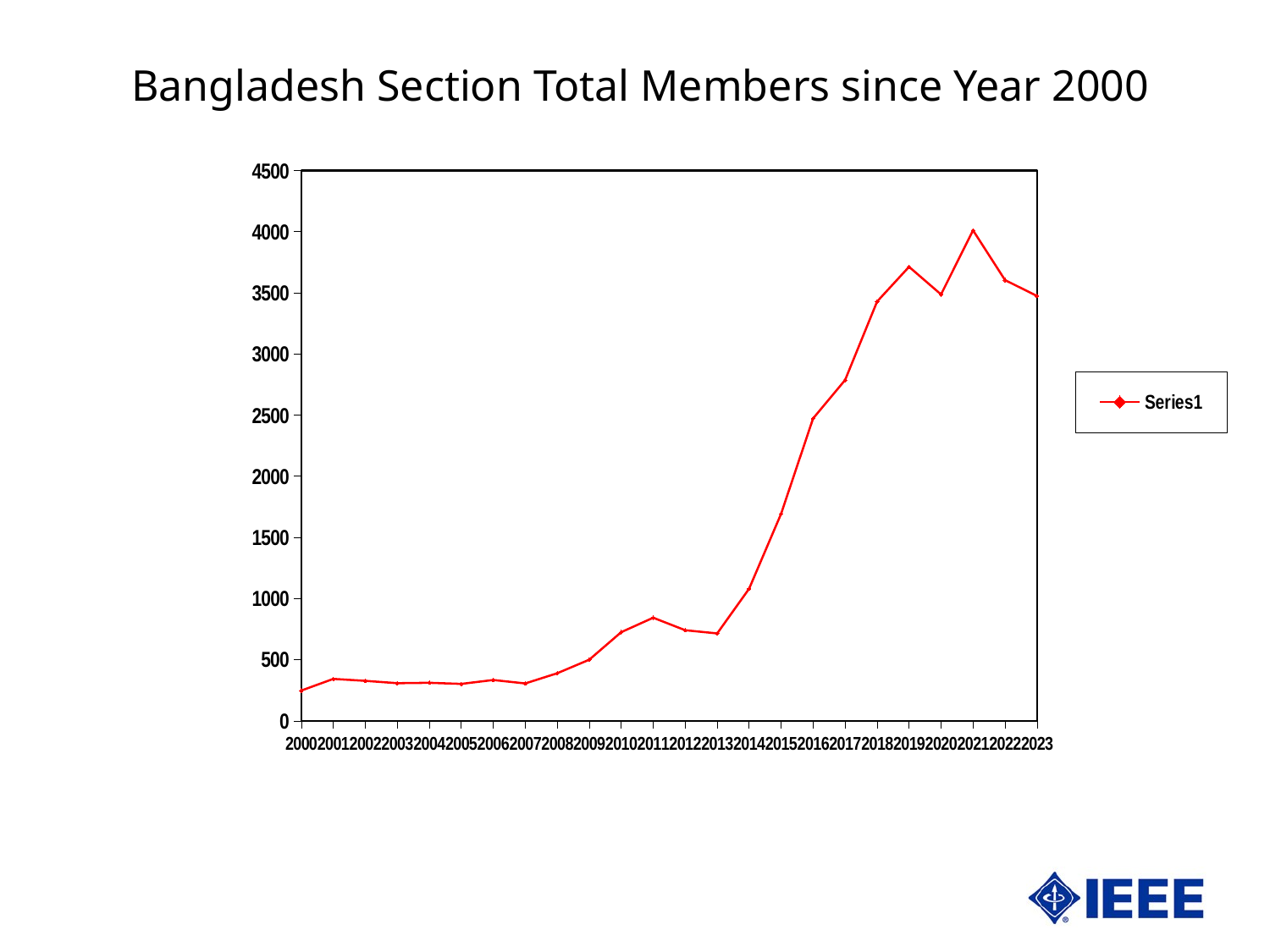
Which year has the larger value, 2019 or 2020? 2019 Is the value for 2021 greater or less than 3500? greater What is the name of the series shown in the legend? Series1 What kind of chart is shown on the slide? line chart How many series does the legend list? 1 Overall, do the values rise or fall from 2000 to 2023? rise Is the value for 2013 greater or less than 1000? less Is the value for 2015 greater or less than 2000? less Which year has the larger value, 2021 or 2022? 2021 In which year is the total membership highest? 2021 How many years (data points) are plotted on the x axis? 24